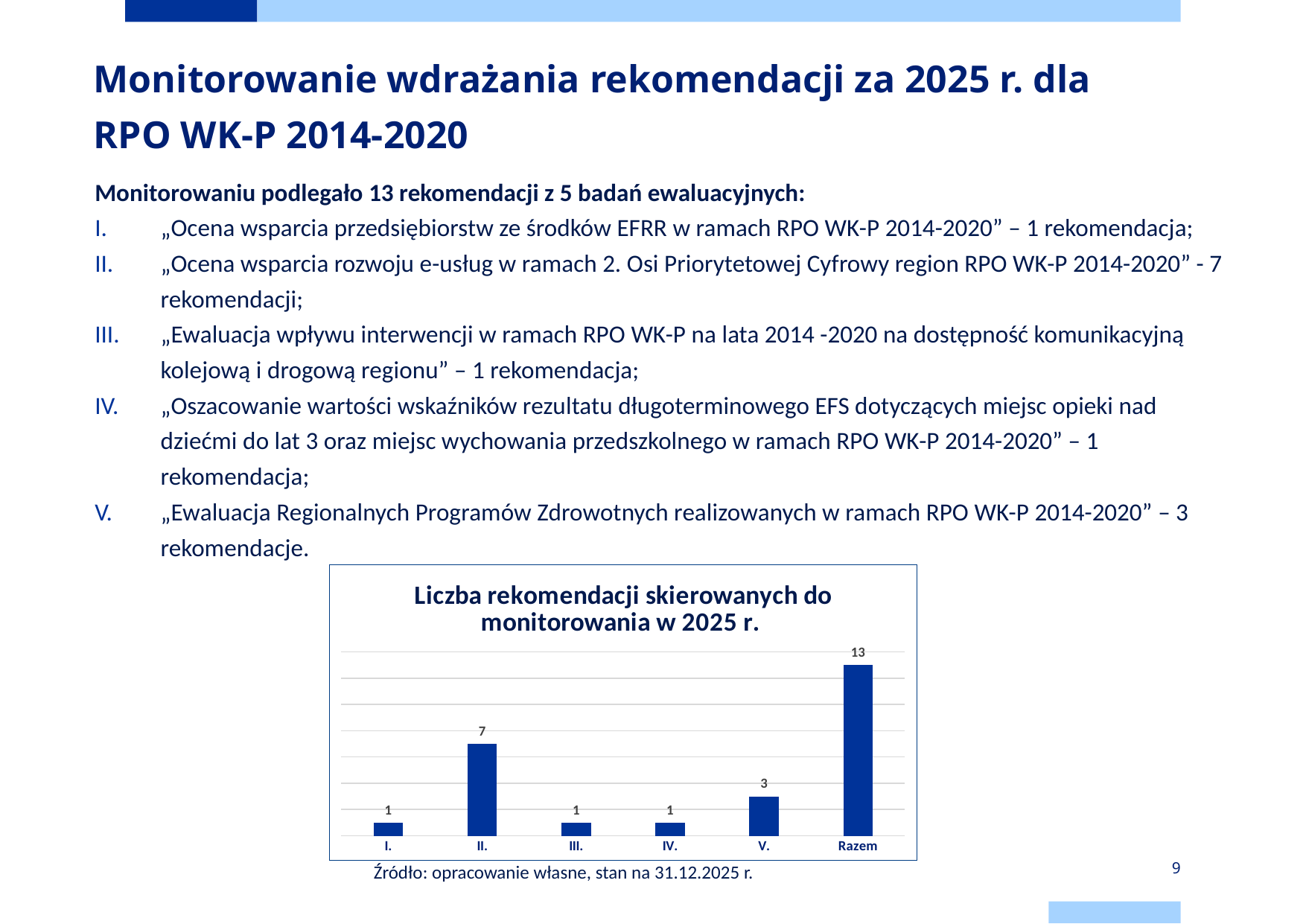
Which category has the highest value in the chart? Razem What is the difference between the Razem bar and the II. bar? 6 Which is larger, the value for V. or the value for IV.? V. Excluding the Razem total bar, which category has the highest value? II. What is the difference between the values for II. and V.? 4 What is the value for category V.? 3 How many categories in the chart have a value of 1? 3 What kind of chart is shown on the slide? bar chart How many categories are shown on the x axis of the chart? 6 What is the value for the Razem bar? 13 What is the value for category II. in the chart? 7 What is the title of the chart? Liczba rekomendacji skierowanych do monitorowania w 2025 r.